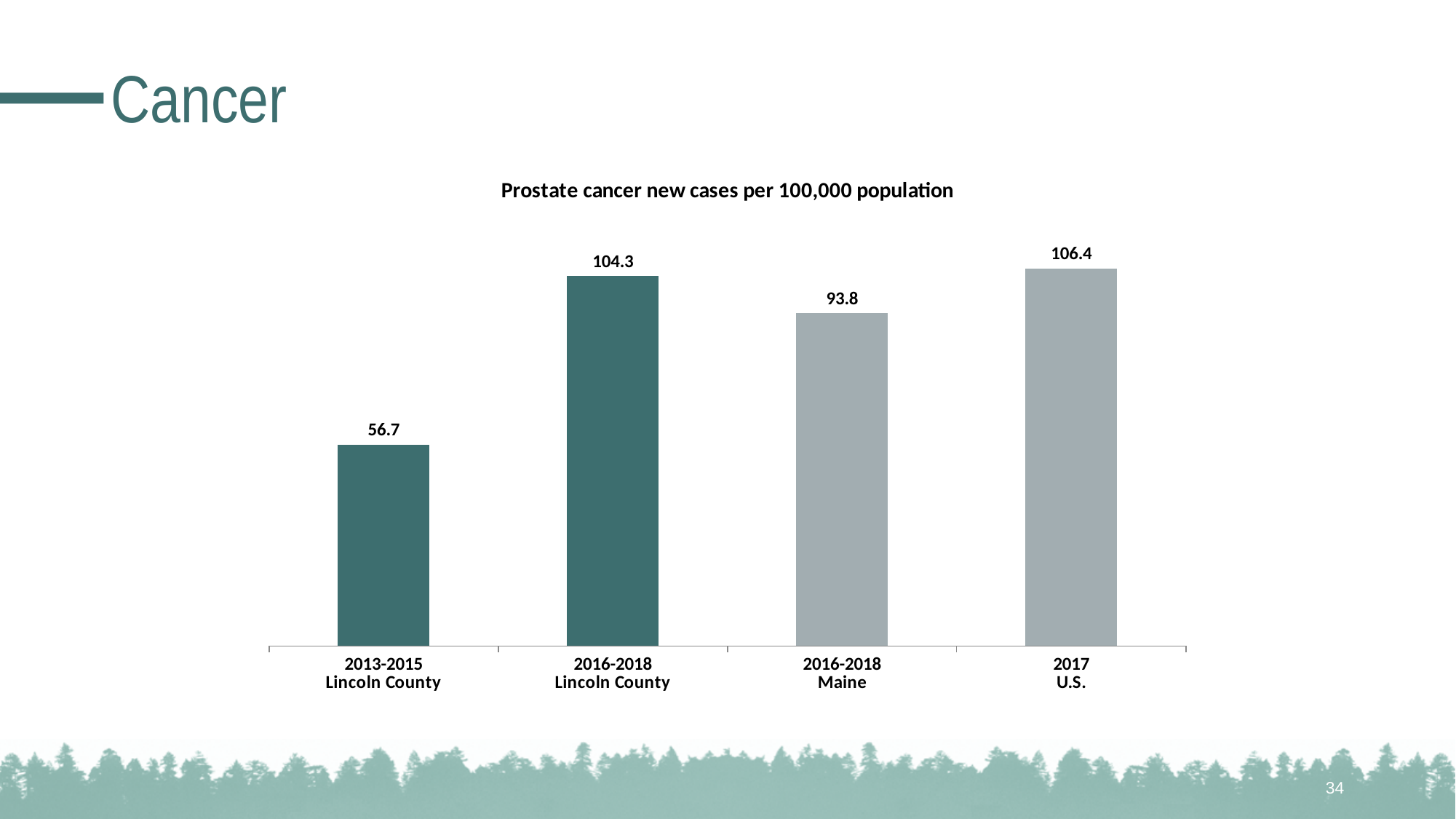
How many bars are shown in the chart? 4 Which category has the highest value? 2017 U.S. What is the difference between the 2017 U.S. value and the 2016-2018 Maine value? 12.6 What is the value for 2017 U.S.? 106.4 What is the difference between the 2016-2018 Lincoln County value and the 2013-2015 Lincoln County value? 47.6 What is the value for 2016-2018 Maine? 93.8 What kind of chart is shown on the slide? Bar chart What is the value for 2013-2015 Lincoln County? 56.7 Which category has the lowest value? 2013-2015 Lincoln County Which is larger, the value for 2016-2018 Lincoln County or the value for 2016-2018 Maine? 2016-2018 Lincoln County What is the title of the chart? Prostate cancer new cases per 100,000 population What is the value for 2016-2018 Lincoln County? 104.3